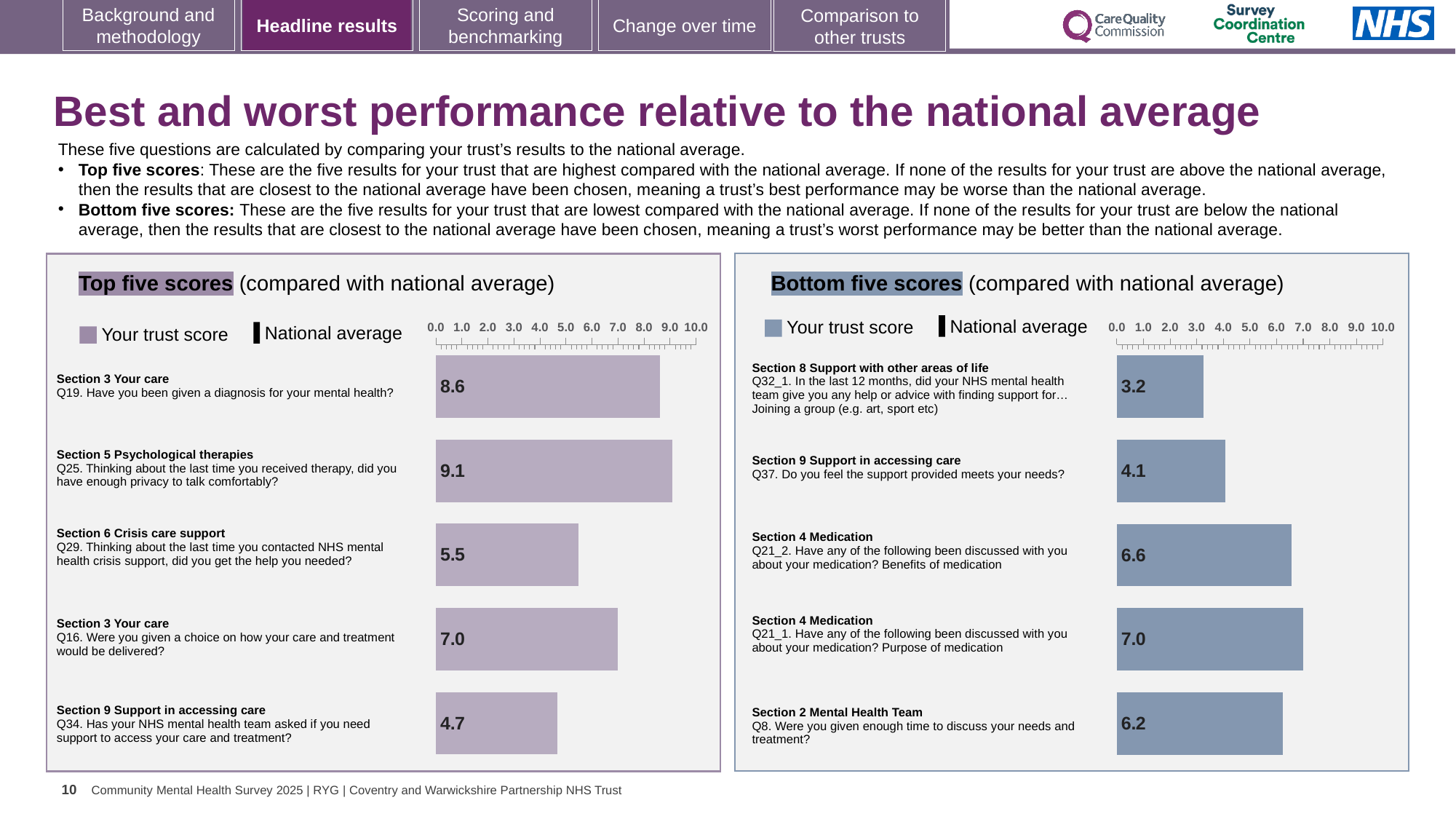
In the Bottom five scores chart, what is the difference between the trust scores for Q21_1 and Q32_1? 3.8 In the Bottom five scores chart, what is the trust score for Q37 (support provided meets your needs)? 4.1 In the Top five scores chart, what is the trust score for Q34 (asked if you need support to access care and treatment)? 4.7 In the Bottom five scores chart, what is the trust score for Q8 (enough time to discuss your needs and treatment)? 6.2 What kind of chart is the Bottom five scores chart? Bar chart How many bars are plotted in the Top five scores chart? 5 In the Bottom five scores chart, which question has the lowest trust score? Q32_1 In the Bottom five scores chart, which has the larger trust score, Q21_2 or Q8? Q21_2 In the Top five scores chart, what is the trust score for Q25 (enough privacy to talk comfortably during therapy)? 9.1 In the Top five scores chart, what is the difference between the trust scores for Q19 and Q29? 3.1 In the Top five scores chart, which question has the highest trust score? Q25 How many series does the legend of the Top five scores chart list? 2